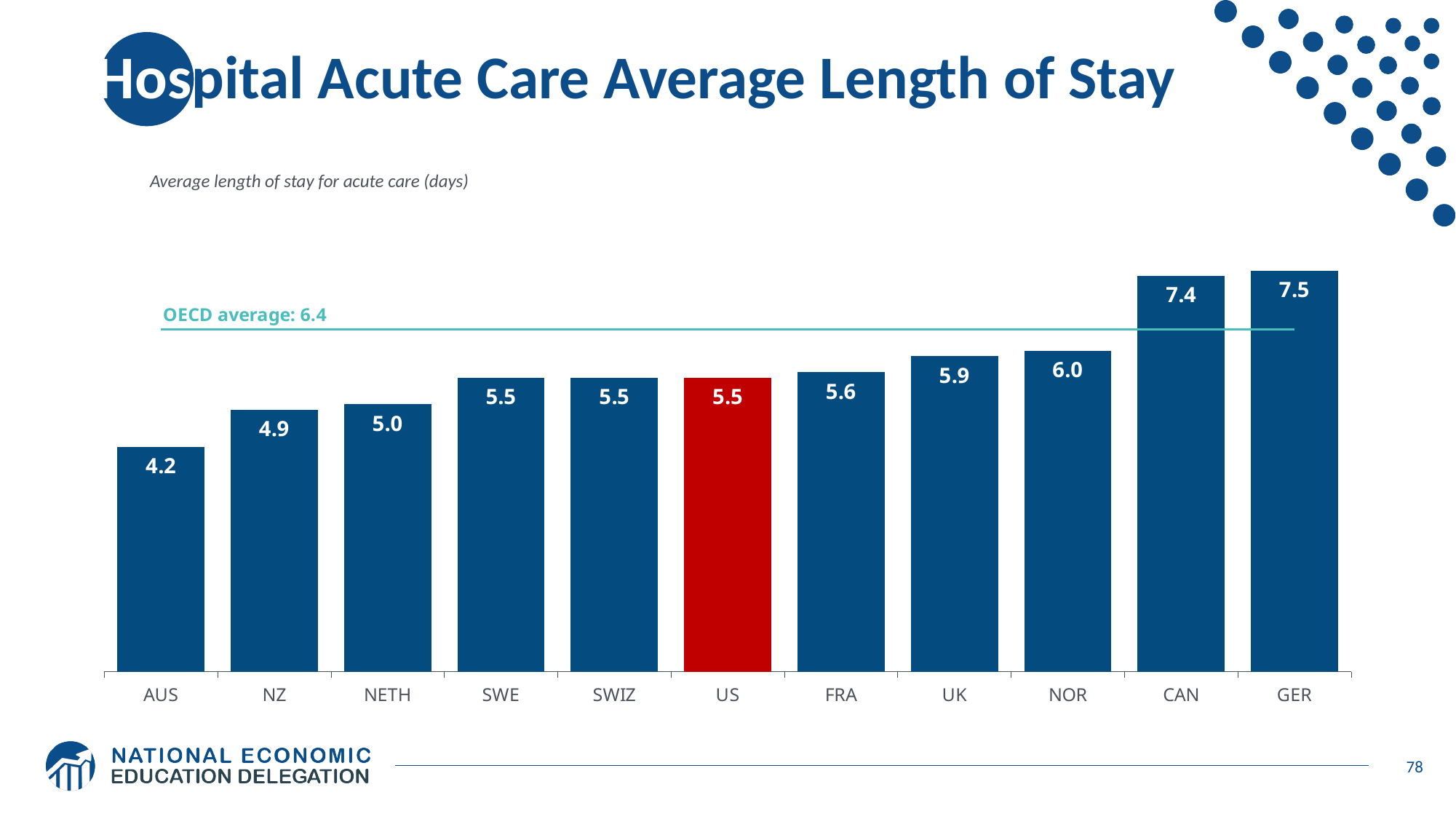
What is the difference between the value for NOR and the value for NZ? 1.1 What OECD average value is marked by the horizontal line on the chart? 6.4 What is the average length of stay for acute care in the US? 5.5 Which has a longer average length of stay, UK or FRA? UK What is the average length of stay for acute care in Germany (GER)? 7.5 Which country has the lowest average length of stay for acute care? AUS How many countries are shown on the chart? 11 What is the value shown for AUS? 4.2 Which country has the highest average length of stay for acute care? GER Do the values generally rise or fall from left to right across the chart? Rise What type of chart is shown on the slide? Bar chart What is the difference in average length of stay between CAN and AUS? 3.2